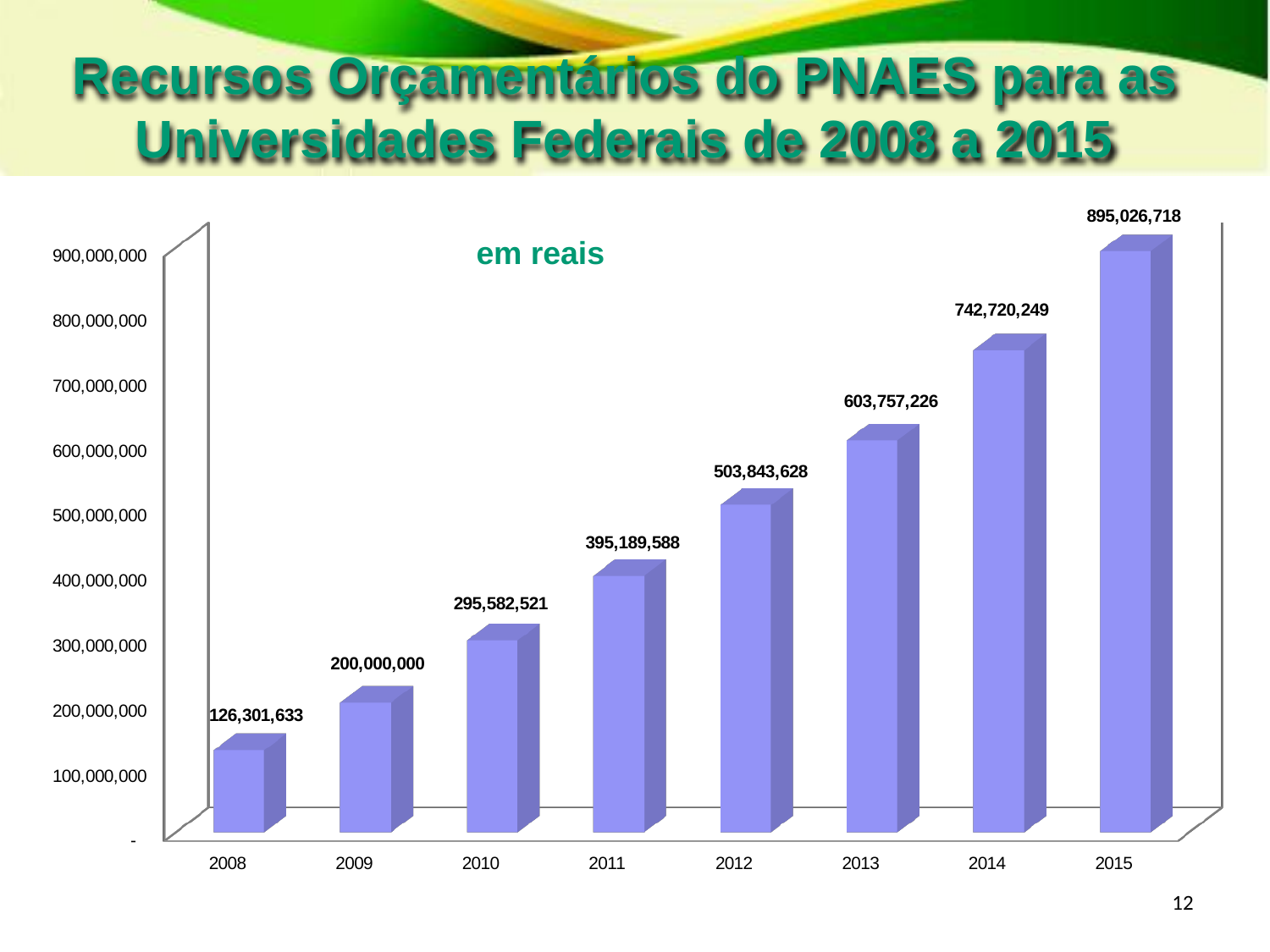
Which year has the lowest value? 2008 What value is shown for 2010? 295,582,521 Is the value for 2011 greater or less than 400,000,000? less How many years are shown on the x axis? 8 Which year has a larger value, 2011 or 2013? 2013 What kind of chart is shown on the slide? bar chart What value is shown for 2014? 742,720,249 Do the values rise or fall from 2008 to 2015? rise What is the difference between the 2009 and 2008 values? 73,698,367 What was the PNAES budget value for 2012? 503,843,628 Which year has the highest value? 2015 What is the difference between the 2015 and 2014 values? 152,306,469